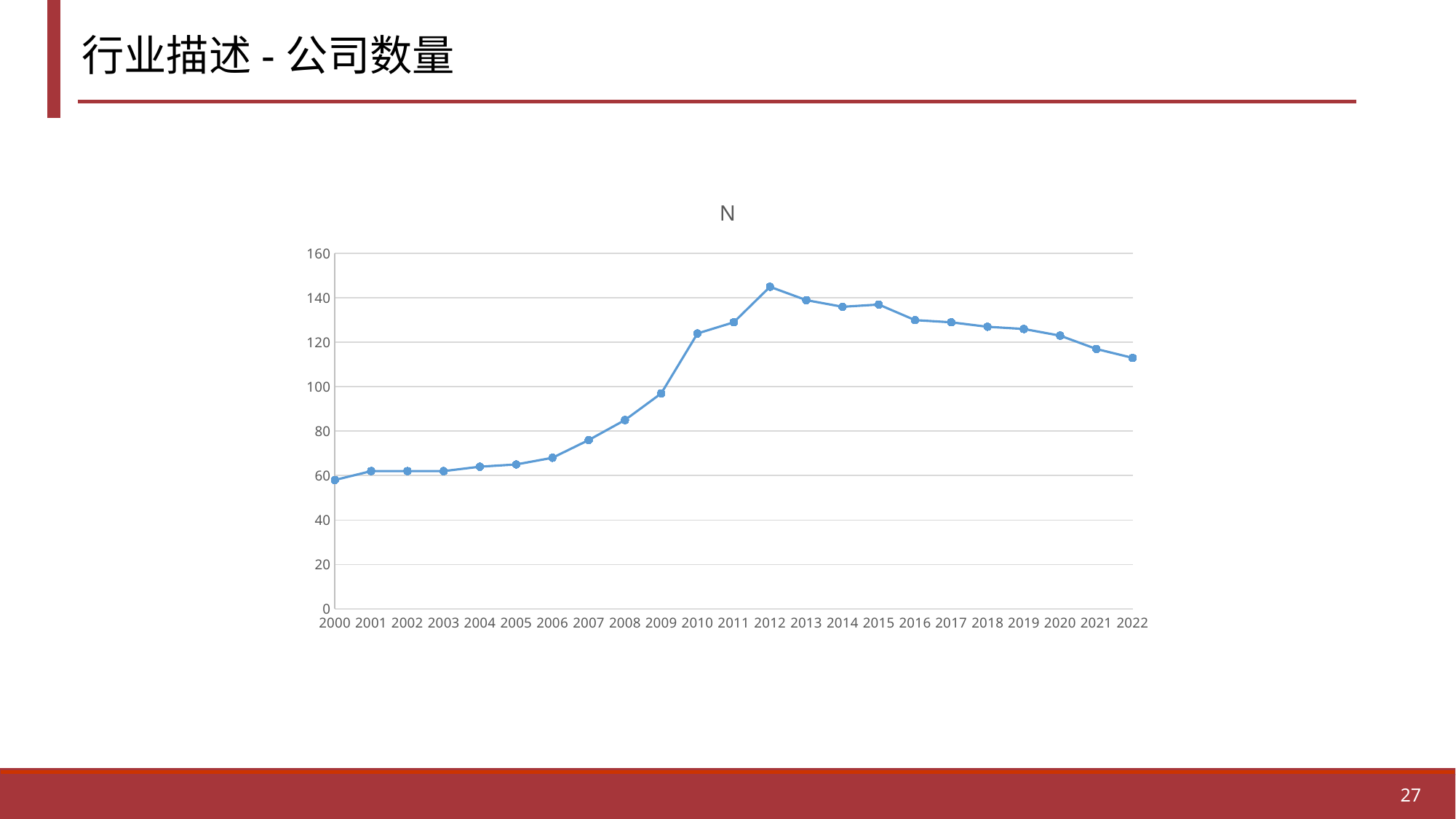
Do the values rise or fall from 2000 to 2012? rise Is the value for 2010 greater or less than 120? greater Is the value for 2022 greater or less than 120? less What kind of chart is shown on the slide? line chart Which year has the lowest value in the chart? 2000 What is the title of the chart? N Do the values rise or fall from 2012 to 2022? fall Which year has the highest value in the chart? 2012 How many years are plotted on the x axis of the chart? 23 Is the value for 2012 greater or less than 140? greater Which year has the larger value, 2012 or 2022? 2012